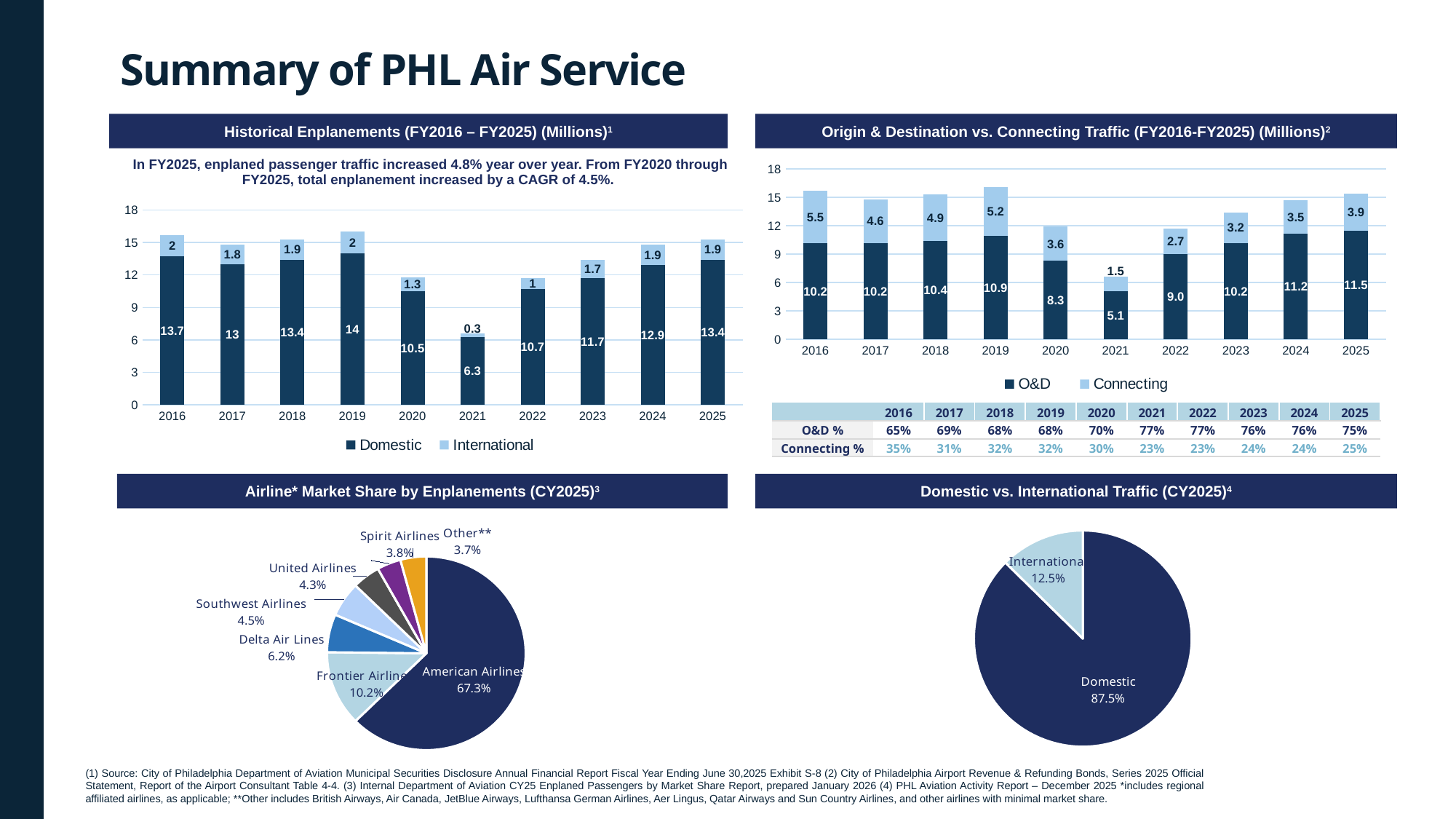
In the Historical Enplanements chart, what is the Domestic value for 2021? 6.3 In the Historical Enplanements chart, what is the International value for 2020? 1.3 In the Origin & Destination vs. Connecting Traffic chart, which year has the highest O&D value? 2025 What kind of chart is the Domestic vs. International Traffic chart? Pie chart In the Historical Enplanements chart, which year has the lowest Domestic value? 2021 In the Domestic vs. International Traffic chart, what share is International? 12.5% In the Airline Market Share by Enplanements chart, what share does Frontier Airlines have? 10.2% In the Origin & Destination vs. Connecting Traffic chart, what is the difference between the O&D values for 2025 and 2021? 6.4 In the Origin & Destination vs. Connecting Traffic chart, what is the Connecting value for 2019? 5.2 In the Airline Market Share by Enplanements chart, which airline has the largest share? American Airlines In the Historical Enplanements chart, what is the total of the stacked bar for 2025? 15.3 In the Origin & Destination vs. Connecting Traffic chart, how many series does the legend list? 2